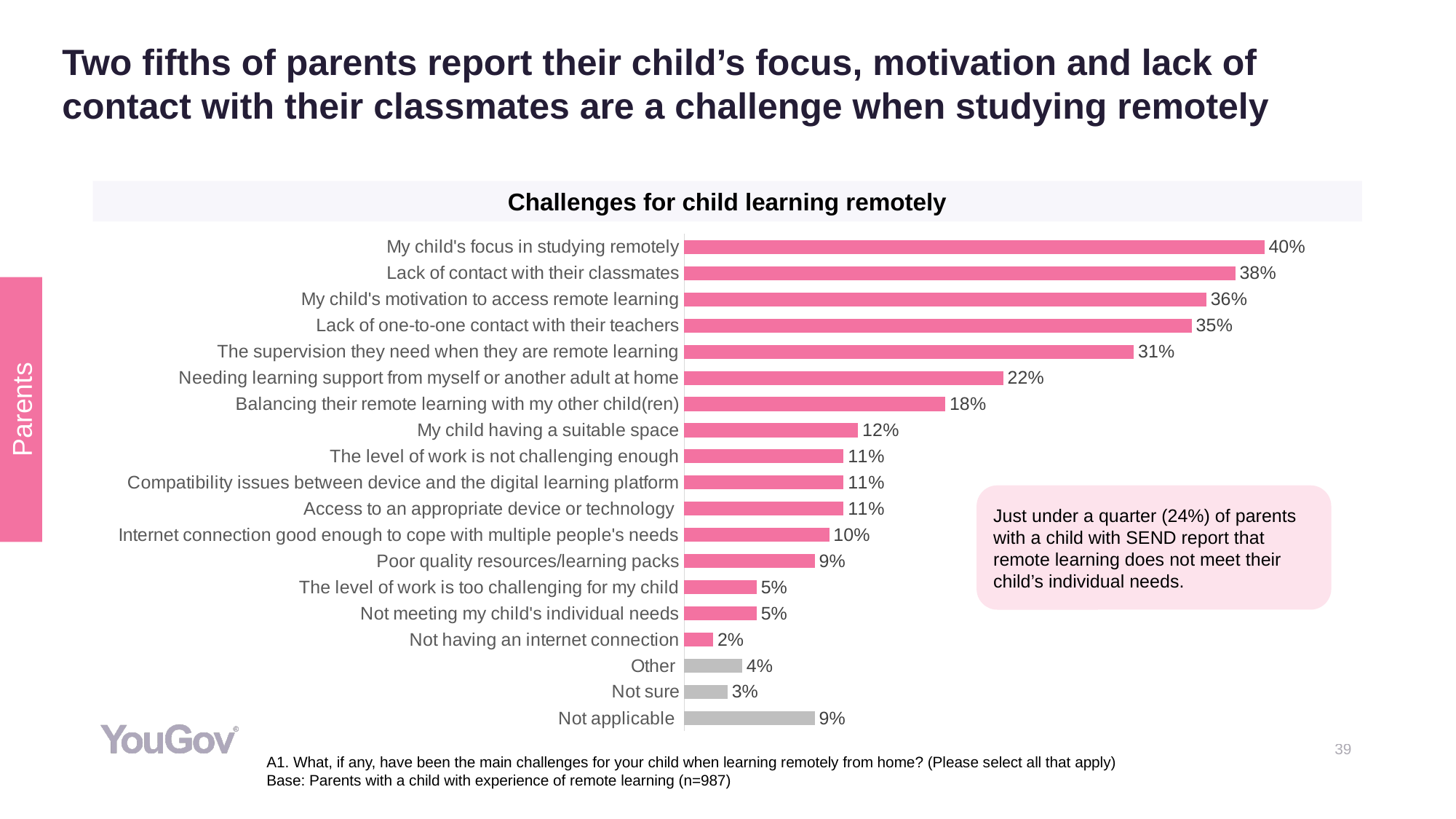
What percentage is shown for 'Not having an internet connection'? 2% Which challenge has the highest percentage in the chart? My child's focus in studying remotely Which is larger: 'Needing learning support from myself or another adult at home' or 'Balancing their remote learning with my other child(ren)'? Needing learning support from myself or another adult at home What is the title of the chart? Challenges for child learning remotely How many categories are shown in the chart? 19 What percentage of parents report their child's focus in studying remotely as a challenge? 40% What is the value for 'Lack of one-to-one contact with their teachers'? 35% What is the difference between 'Lack of contact with their classmates' and 'The supervision they need when they are remote learning'? 7% Which category has the lowest percentage in the chart? Not having an internet connection What is the value for 'Not applicable'? 9% What kind of chart is shown on the slide? Bar chart Which categories are shown with grey bars instead of pink? Other, Not sure, Not applicable